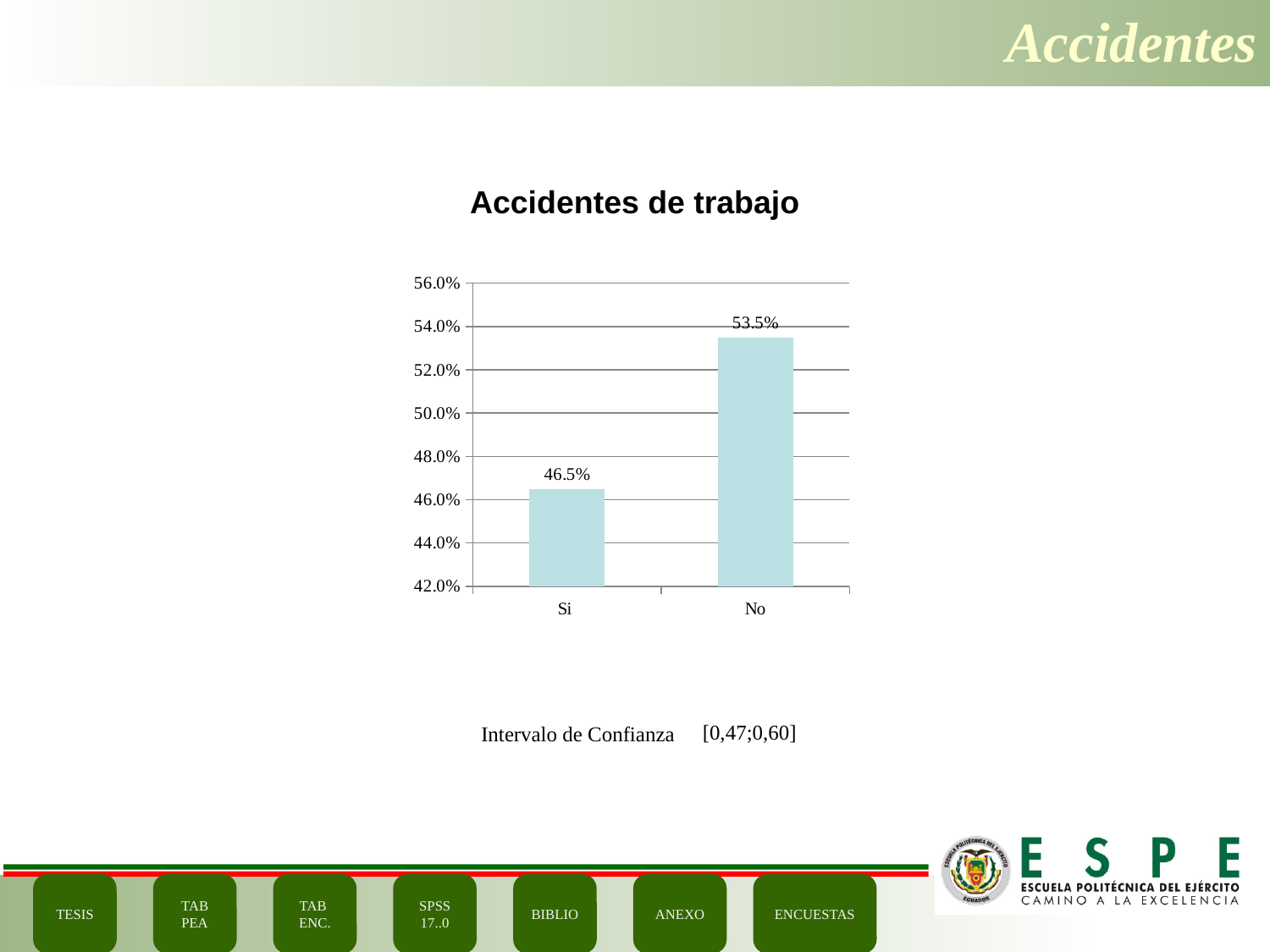
Which is larger, the value for Si or the value for No? No What kind of chart is shown on the slide? bar chart What is the difference between the values for No and Si? 7.0% Is the value for Si greater or less than 50.0%? less What is the title of the chart? Accidentes de trabajo What is the value for No? 53.5% Which category has the lowest value? Si How many categories are shown on the x axis? 2 Which category has the highest value? No Is the value for No greater or less than 52.0%? greater What is the highest value shown on the y axis? 56.0% What is the value for Si? 46.5%